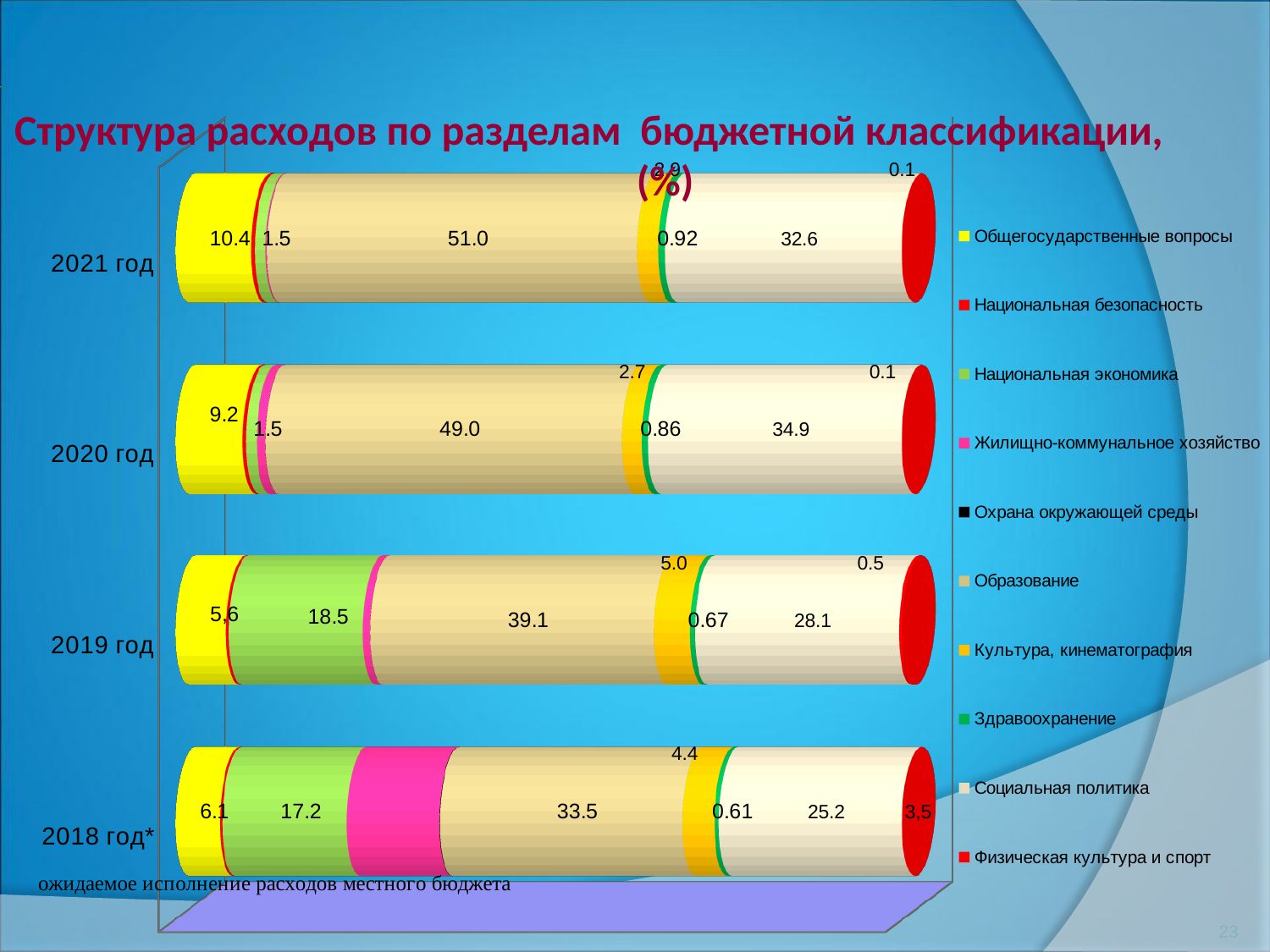
What is the value for Физическая культура и спорт in 2018 год*? 3,5 What is the value for Культура, кинематография in 2019 год? 5.0 How many years (categories) are plotted in the chart? 4 What is the value for Образование in 2021 год? 51.0 What is the difference between the Образование values for 2021 год and 2020 год? 2.0 In which year is the value for Образование the highest? 2021 год What kind of chart is shown on the slide? bar chart What is the value for Общегосударственные вопросы in 2019 год? 5,6 Which year has the larger value for Социальная политика, 2020 год or 2019 год? 2020 год What is the value for Образование in 2018 год*? 33.5 How many series does the legend list? 10 What is the value for Социальная политика in 2020 год? 34.9